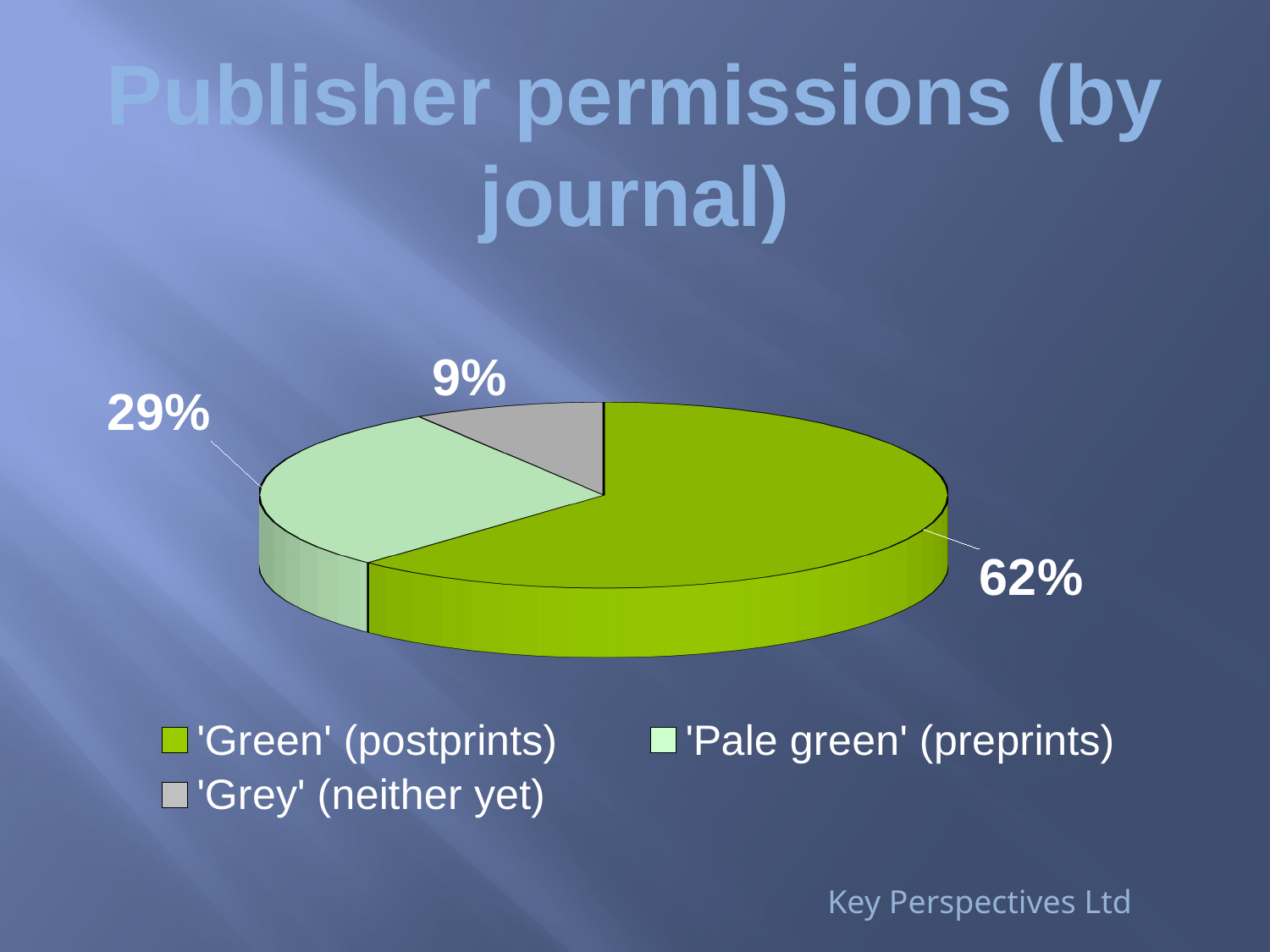
What is the difference in percentage points between 'Pale green' (preprints) and 'Grey' (neither yet)? 20 Which category has the smallest share of the pie? 'Grey' (neither yet) What colour is the slice for 'Grey' (neither yet)? grey What share of the pie is 'Grey' (neither yet)? 9% Which category has the largest share of the pie? 'Green' (postprints) Which is larger, the share for 'Pale green' (preprints) or the share for 'Grey' (neither yet)? 'Pale green' (preprints) How many slices does the pie chart have? 3 What is the title of the chart? Publisher permissions (by journal) What share of the pie is 'Pale green' (preprints)? 29% What share of the pie is 'Green' (postprints)? 62% What type of chart is shown on the slide? pie chart What is the difference in percentage points between 'Green' (postprints) and 'Pale green' (preprints)? 33